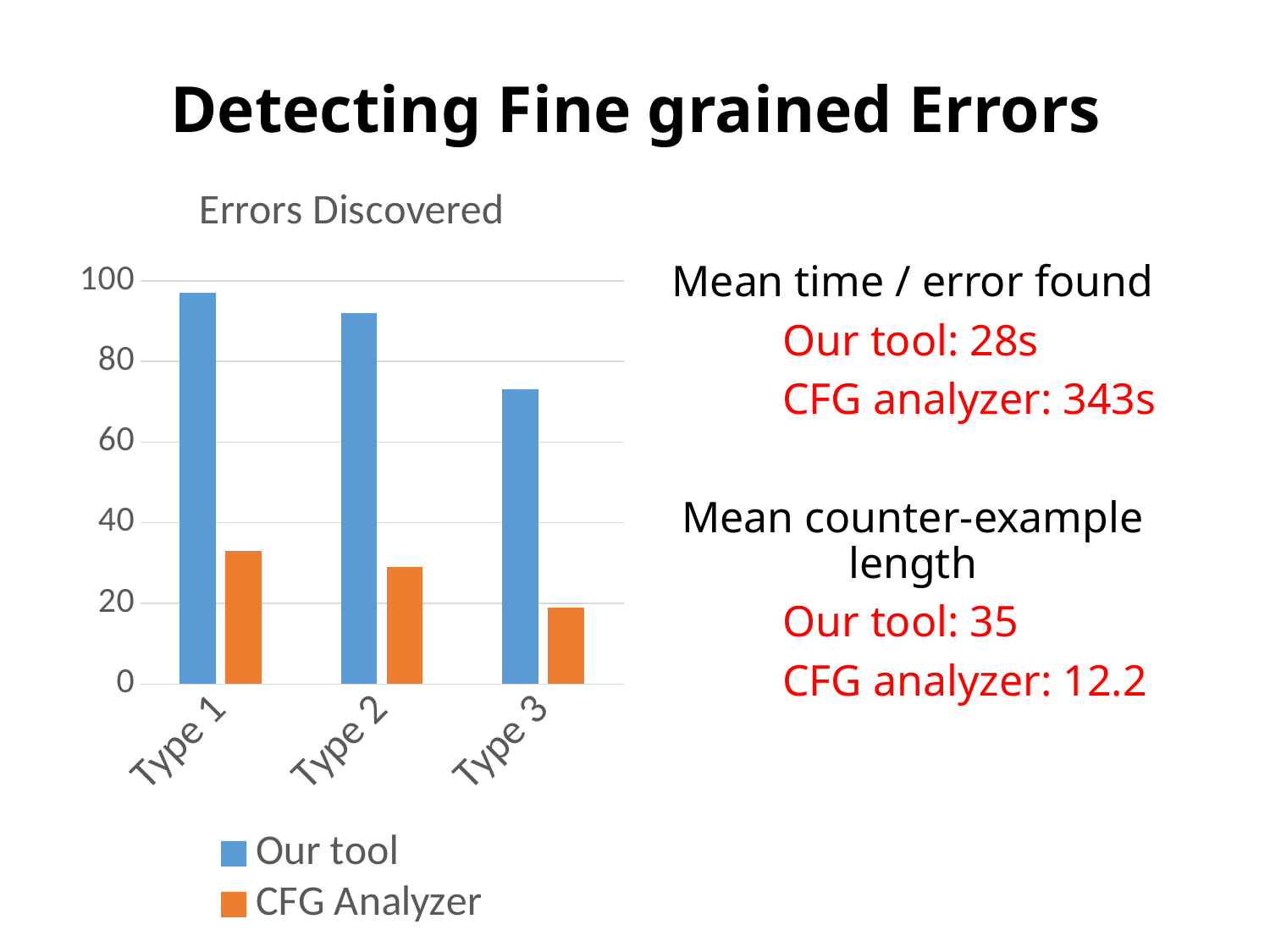
For which type does "Our tool" have the lowest number of errors discovered? Type 3 Which series is shown in orange in the "Errors Discovered" chart? CFG Analyzer What kind of chart is shown under the title "Errors Discovered"? bar chart For which type does "CFG Analyzer" have the lowest number of errors discovered? Type 3 How many series does the legend of the "Errors Discovered" chart list? 2 Do the values for "Our tool" rise or fall from Type 1 to Type 3? fall Is the value for "Our tool" at Type 1 greater or less than 80? greater Is the value for "CFG Analyzer" at Type 3 greater or less than 40? less Is the value for "CFG Analyzer" at Type 1 greater or less than 20? greater For Type 2, which series has the larger value, "Our tool" or "CFG Analyzer"? Our tool How many categories are shown on the x axis of the "Errors Discovered" chart? 3